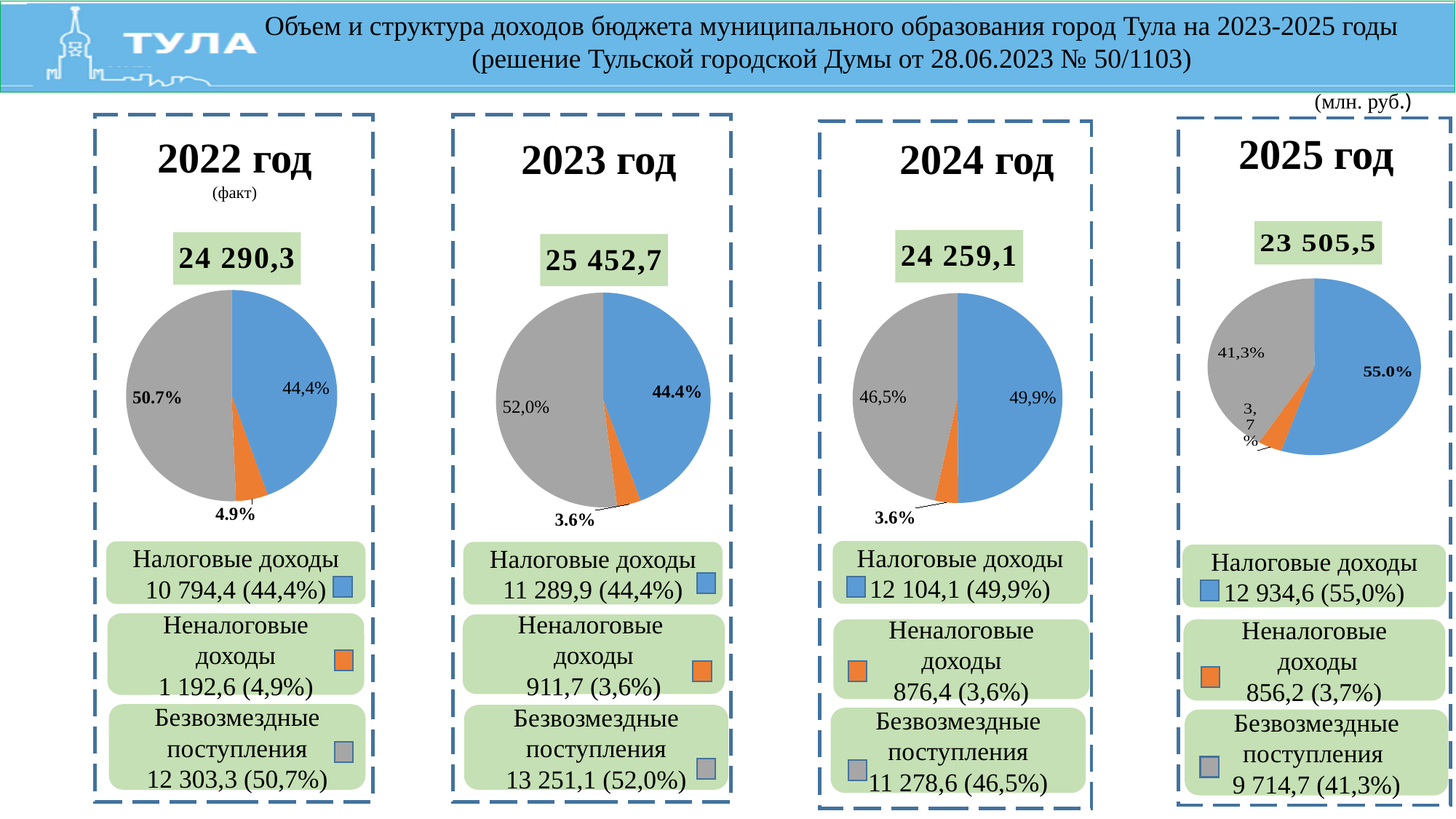
In the 2024 год chart, what is the value of Налоговые доходы in млн. руб.? 12 104,1 What colour represents Неналоговые доходы in the pie charts? Orange In the 2022 год pie chart, what share is shown for Безвозмездные поступления? 50,7% In the 2023 год pie chart, which is larger: Налоговые доходы or Безвозмездные поступления? Безвозмездные поступления In the 2025 год pie chart, which category has the largest slice? Налоговые доходы In the 2023 год pie chart, what share is shown for Налоговые доходы? 44,4% What type of chart is used for each year on the slide? Pie chart In the 2022 год pie chart, which category has the smallest slice? Неналоговые доходы What is the difference in percentage points between Налоговые доходы and Безвозмездные поступления in the 2025 год pie chart? 13,7 In the 2025 год chart, what is the value of Безвозмездные поступления in млн. руб.? 9 714,7 How many slices does each pie chart on the slide have? 3 In the 2024 год pie chart, what share is shown for Неналоговые доходы? 3,6%